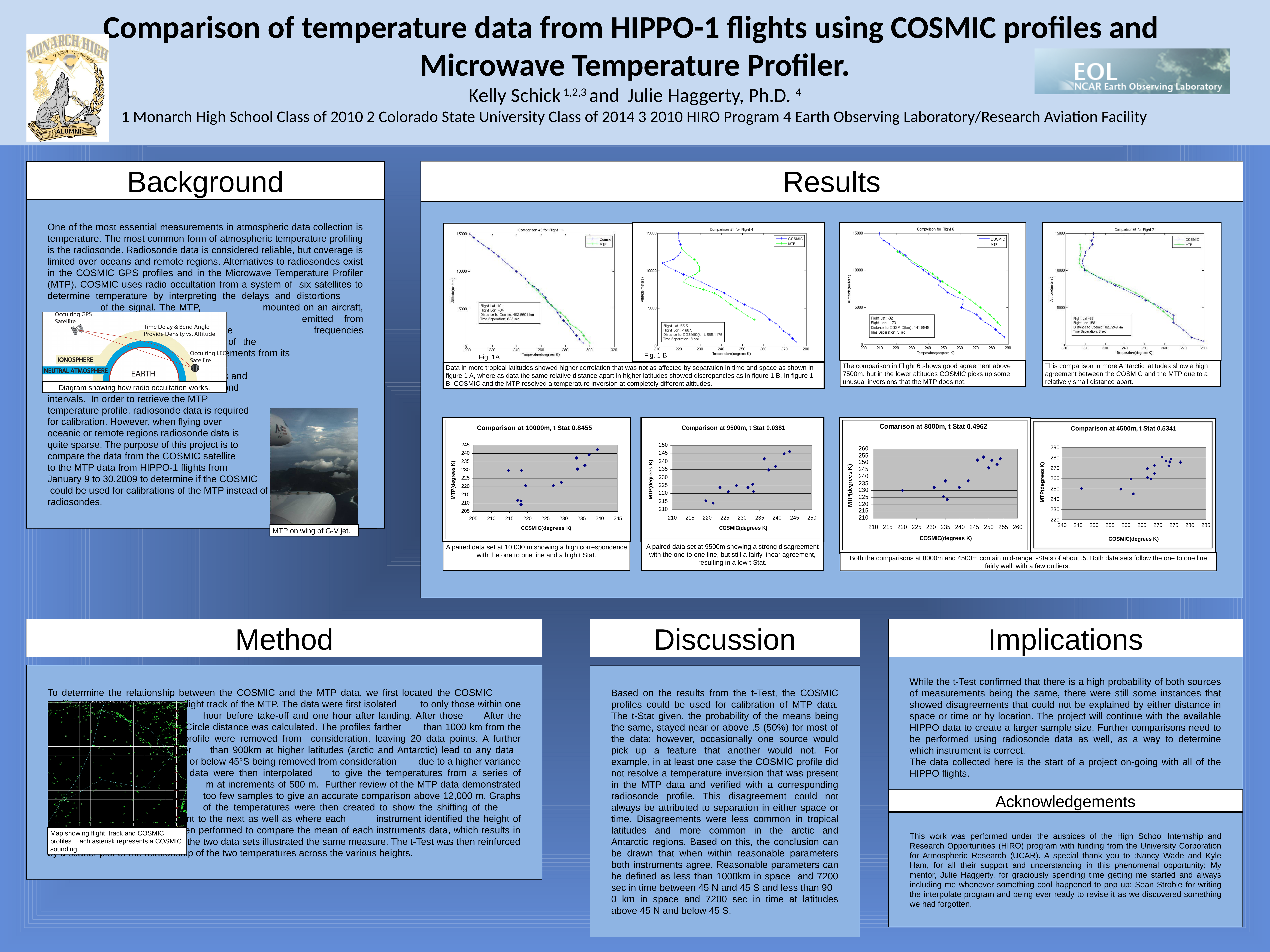
What is the x-axis label of the "Comparison at 9500m, t Stat 0.0381" chart? COSMIC(degrees K) In the "Comparison at 10000m, t Stat 0.8455" chart, is the highest MTP value greater or less than 245? less What are the two series named in the legend of the "Comparison#3 for Flight 7" chart? COSMIC and MTP How many series does the legend list in the "Comparison #1 for Flight 4" chart? 2 What kind of chart is the "Comparison #3 for Flight 11" chart? line chart In the "Comparison #3 for Flight 11" chart, does altitude rise or fall as temperature increases along the x axis? fall In the "Comparison at 4500m, t Stat 0.5341" chart, is the lowest MTP value greater or less than 240? greater In the "Comparison at 10000m, t Stat 0.8455" chart, is the lowest MTP value greater or less than 215? less What kind of chart is the "Comparison at 10000m, t Stat 0.8455" chart? scatter plot How many series does the legend list in the "Comparison for Flight 6" chart? 2 In the "Comparison for Flight 6" chart, does altitude rise or fall as temperature increases along the x axis? fall